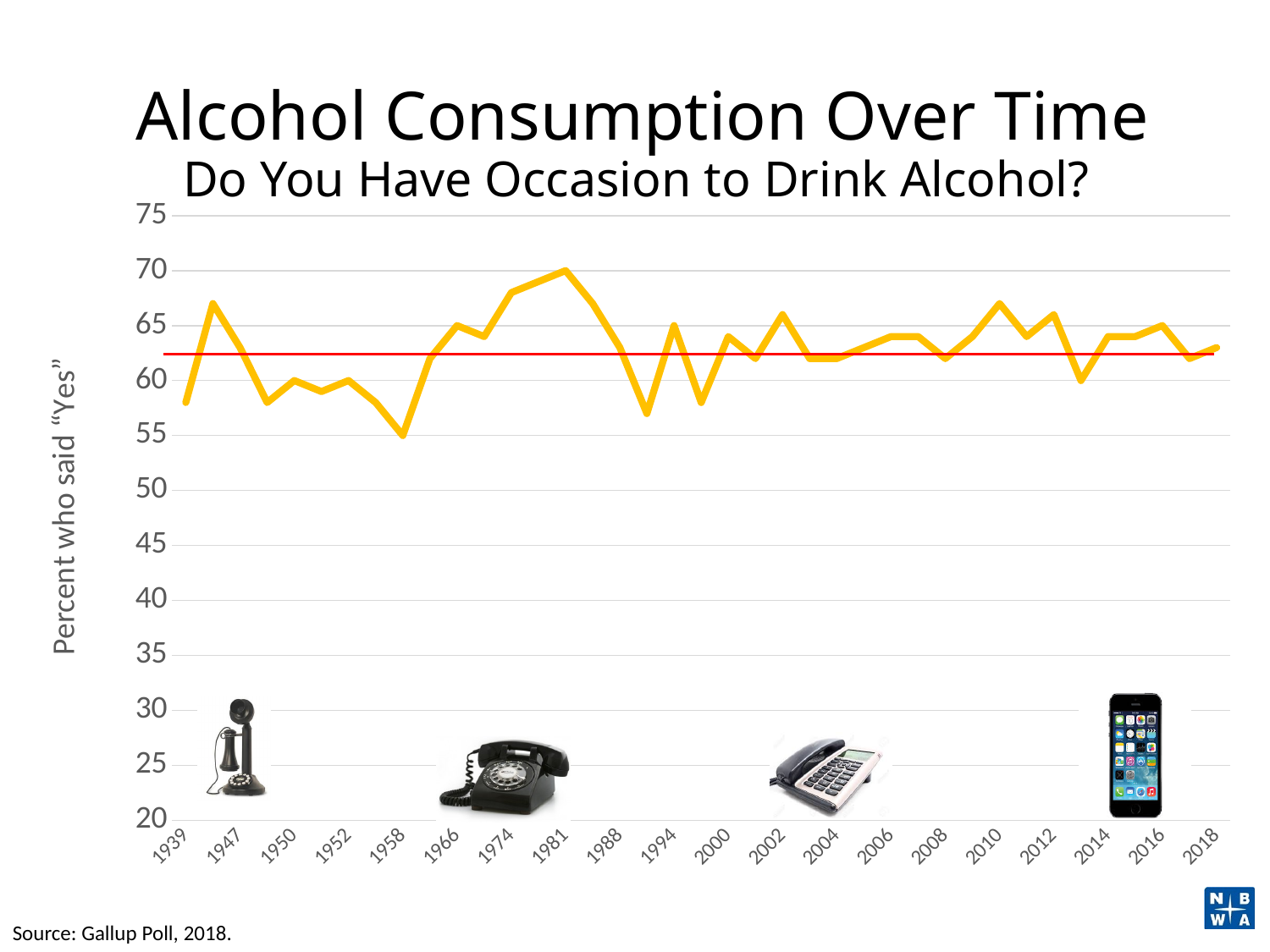
Is the value for 1981 greater or less than 65? greater Is the value for 1947 greater or less than 65? less Which year has the larger value, 1939 or 1947? 1947 Is the value for 1939 greater or less than 60? less What is the label on the vertical axis of the chart? Percent who said "Yes" How many year labels are shown on the horizontal axis? 20 Which labeled year has the highest value on the chart? 1981 What is the title of the chart? Do You Have Occasion to Drink Alcohol? What kind of chart is shown on the slide? line chart Which labeled year has the lowest value on the chart? 1958